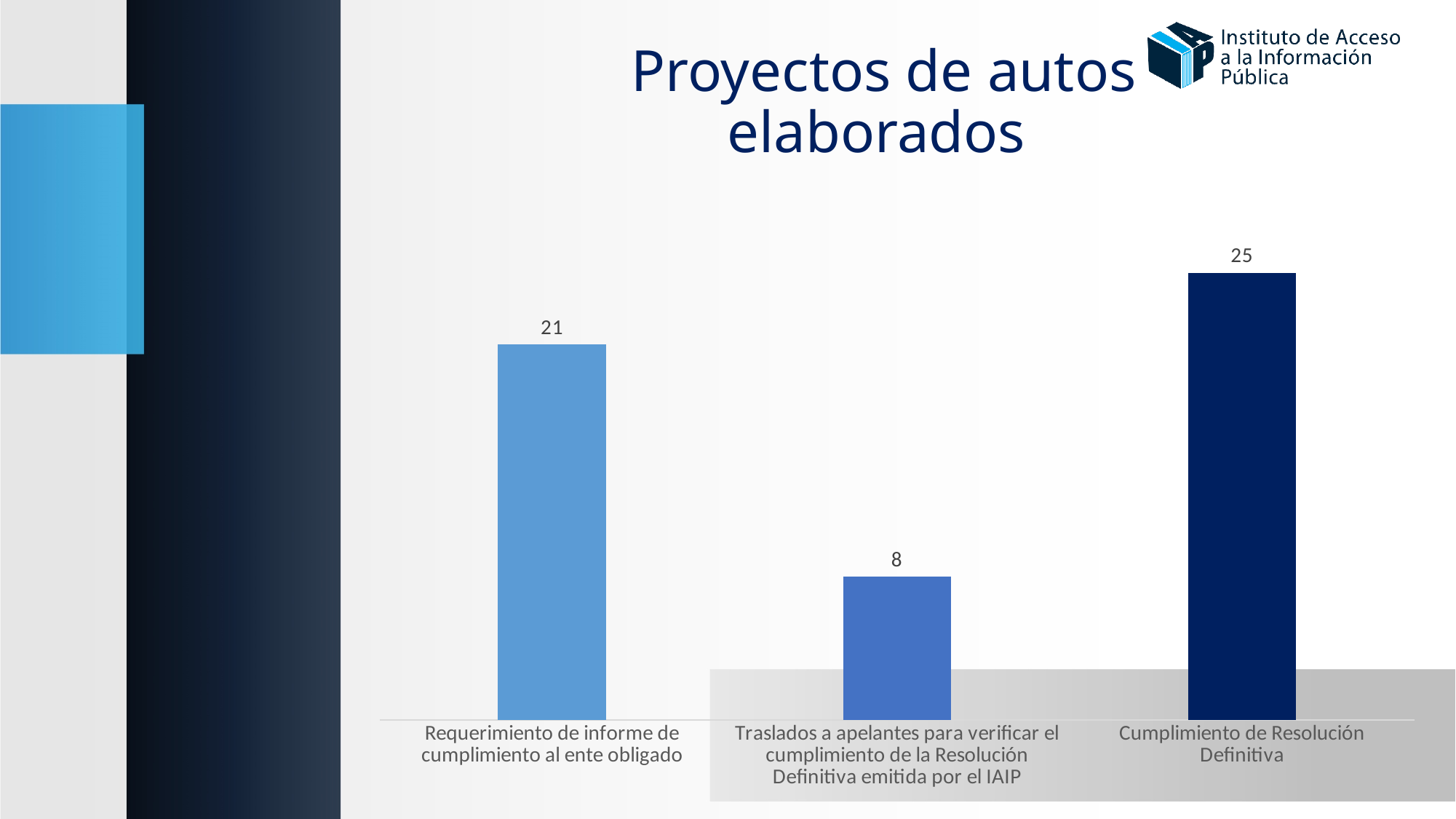
Which category has the lowest value? Traslados a apelantes para verificar el cumplimiento de la Resolución Definitiva emitida por el IAIP What is the value for "Requerimiento de informe de cumplimiento al ente obligado"? 21 What is the difference between the values for "Cumplimiento de Resolución Definitiva" and "Requerimiento de informe de cumplimiento al ente obligado"? 4 What is the difference between the values for "Requerimiento de informe de cumplimiento al ente obligado" and "Traslados a apelantes para verificar el cumplimiento de la Resolución Definitiva emitida por el IAIP"? 13 How many categories are shown in the chart? 3 What is the value for "Traslados a apelantes para verificar el cumplimiento de la Resolución Definitiva emitida por el IAIP"? 8 Which is larger: the value for "Requerimiento de informe de cumplimiento al ente obligado" or the value for "Traslados a apelantes para verificar el cumplimiento de la Resolución Definitiva emitida por el IAIP"? Requerimiento de informe de cumplimiento al ente obligado What is the value for "Cumplimiento de Resolución Definitiva"? 25 What is the total of all three values shown in the chart? 54 Which category has the highest value? Cumplimiento de Resolución Definitiva What kind of chart is shown on the slide? Bar chart What is the title of the slide? Proyectos de autos elaborados